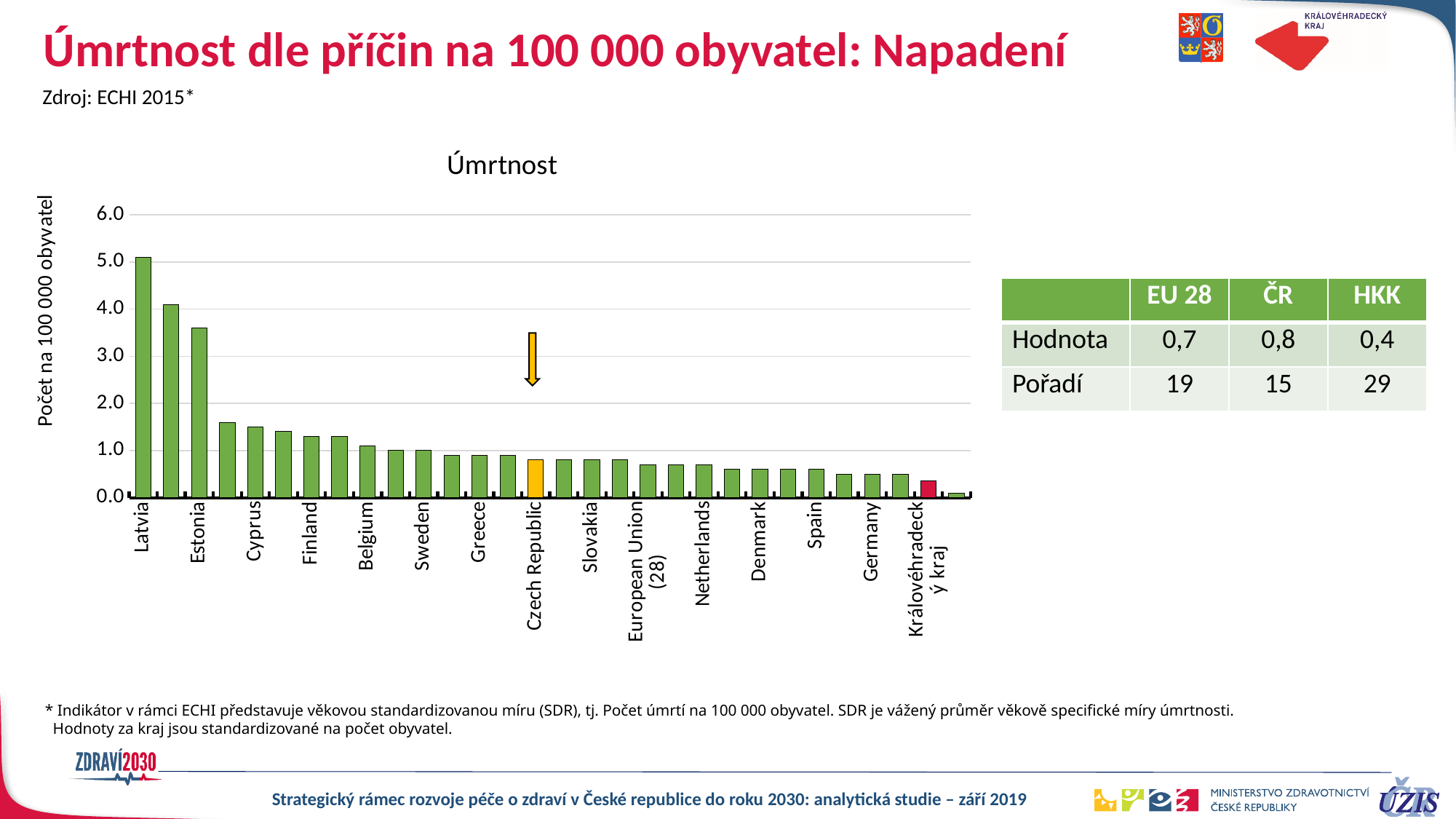
What is the title of the chart? Úmrtnost Is the value for Estonia greater or less than 3.0? greater Which country has the highest value in the chart? Latvia Is the value for Královéhradecký kraj greater or less than 1.0? less According to the table next to the chart, what is the value (Hodnota) for ČR? 0,8 Is the value for Czech Republic greater or less than 1.0? less Which has the larger value, Latvia or Estonia? Latvia What is the label of the vertical axis of the chart? Počet na 100 000 obyvatel What kind of chart is shown on the slide? bar chart Do the values rise or fall from left to right along the x axis? fall